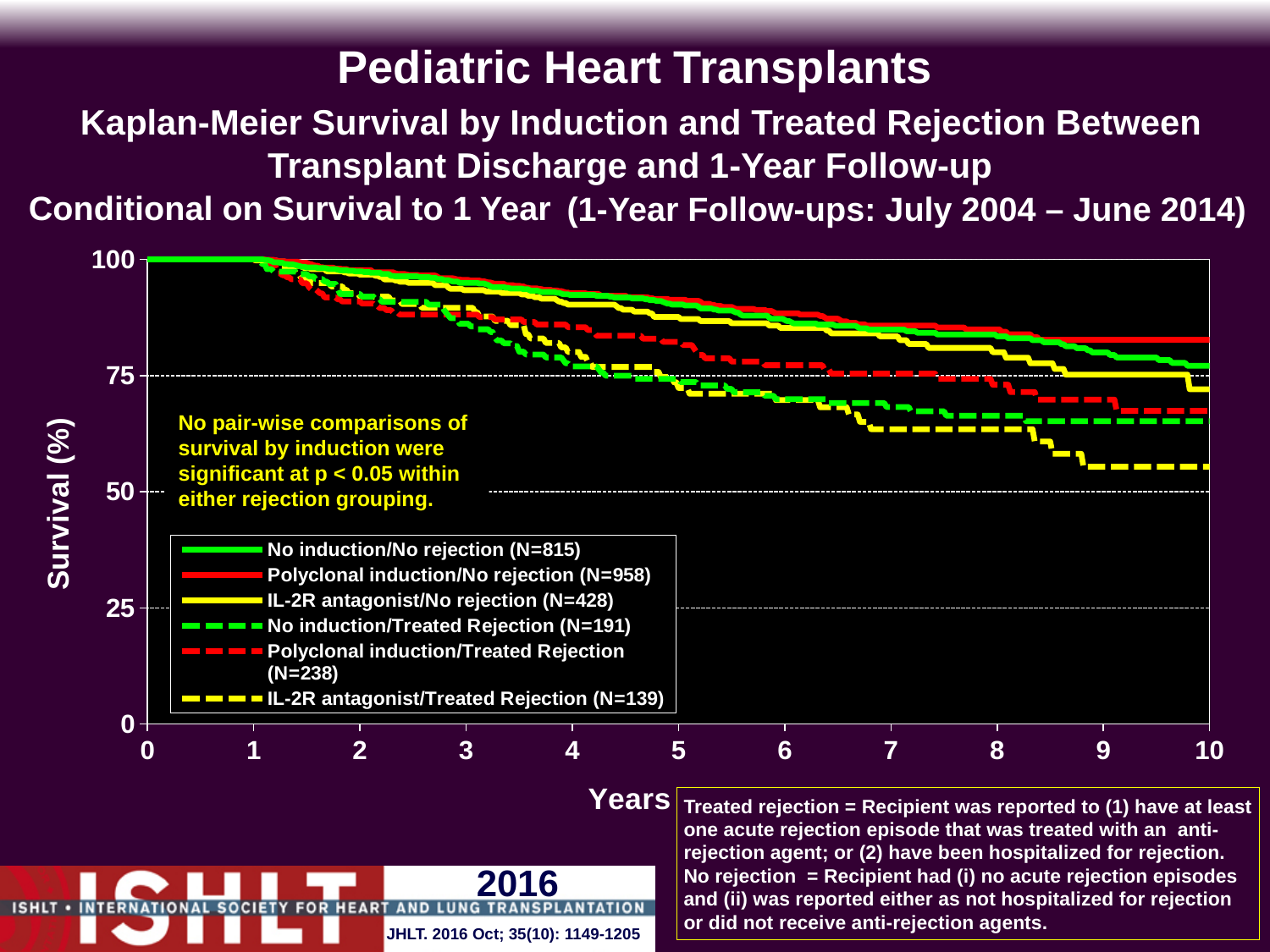
At 10 years, which has higher survival: Polyclonal induction/No rejection or IL-2R antagonist/Treated Rejection? Polyclonal induction/No rejection Which series has the lowest survival at 10 years? IL-2R antagonist/Treated Rejection (N=139) How many series does the legend list? 6 What kind of chart is shown on the slide? Line chart What is the label of the y axis? Survival (%) What is the N for the IL-2R antagonist/Treated Rejection group shown in the legend? N=139 What is the N for the Polyclonal induction/No rejection group shown in the legend? N=958 Is the survival for Polyclonal induction/No rejection at 10 years greater or less than 75? greater Do the survival curves rise or fall as years increase? Fall What is the label of the x axis? Years Is the survival for IL-2R antagonist/Treated Rejection at 10 years greater or less than 75? less Which series has the highest survival at 10 years? Polyclonal induction/No rejection (N=958)